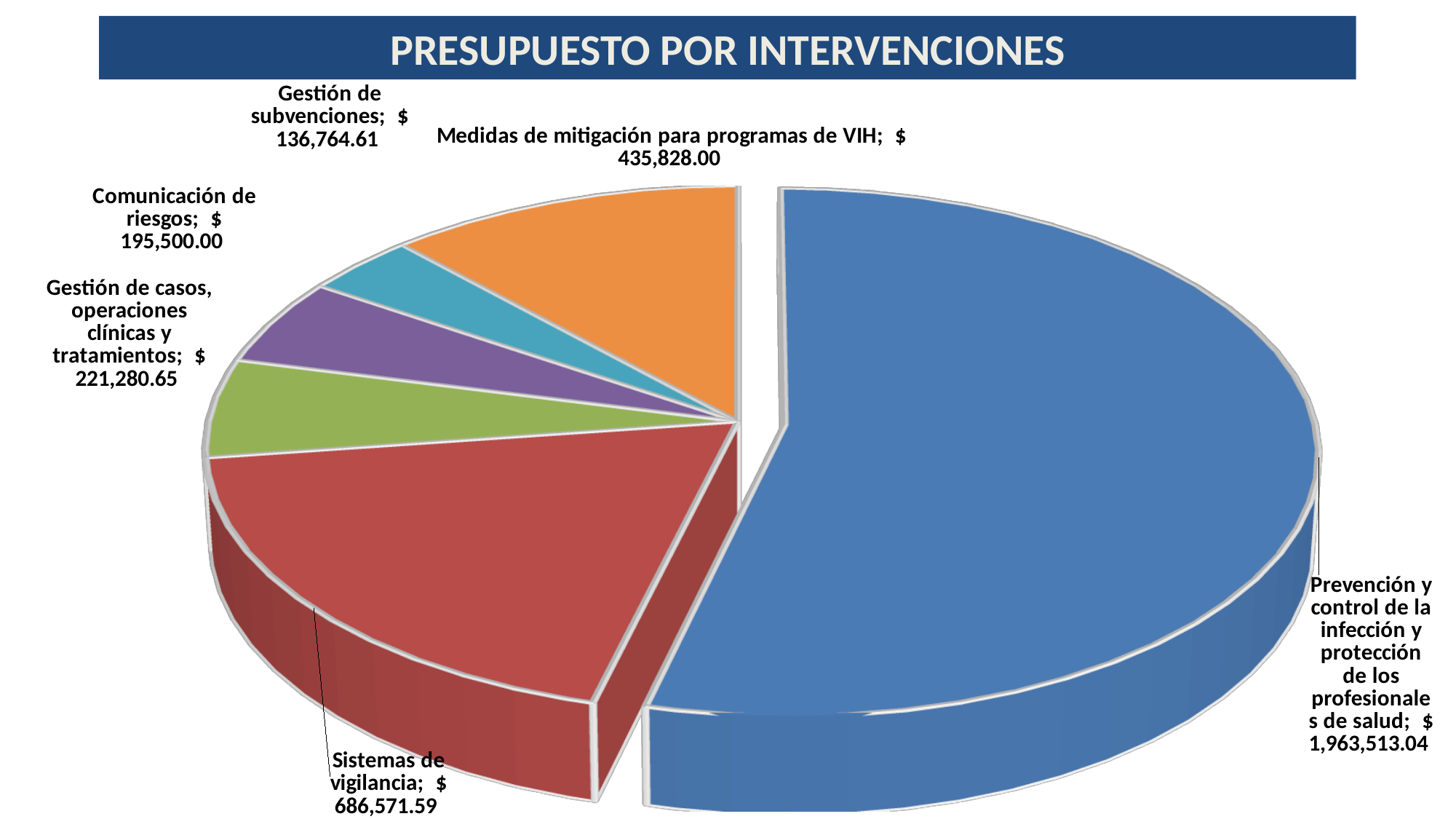
What is the difference between the budgets for Gestión de casos, operaciones clínicas y tratamientos and Comunicación de riesgos? $25,780.65 How many slices does the pie chart have? 6 Which intervention has the smallest budget? Gestión de subvenciones Which intervention has the largest budget? Prevención y control de la infección y protección de los profesionales de salud What is the budget value for Medidas de mitigación para programas de VIH? $435,828.00 What is the budget value for Sistemas de vigilancia? $686,571.59 What is the difference between the budgets for Sistemas de vigilancia and Medidas de mitigación para programas de VIH? $250,743.59 What colour is the slice for Sistemas de vigilancia? Red Which has a larger budget, Comunicación de riesgos or Gestión de subvenciones? Comunicación de riesgos What type of chart is shown on the slide? Pie chart What is the budget value for Comunicación de riesgos? $195,500.00 What is the title of the chart? PRESUPUESTO POR INTERVENCIONES